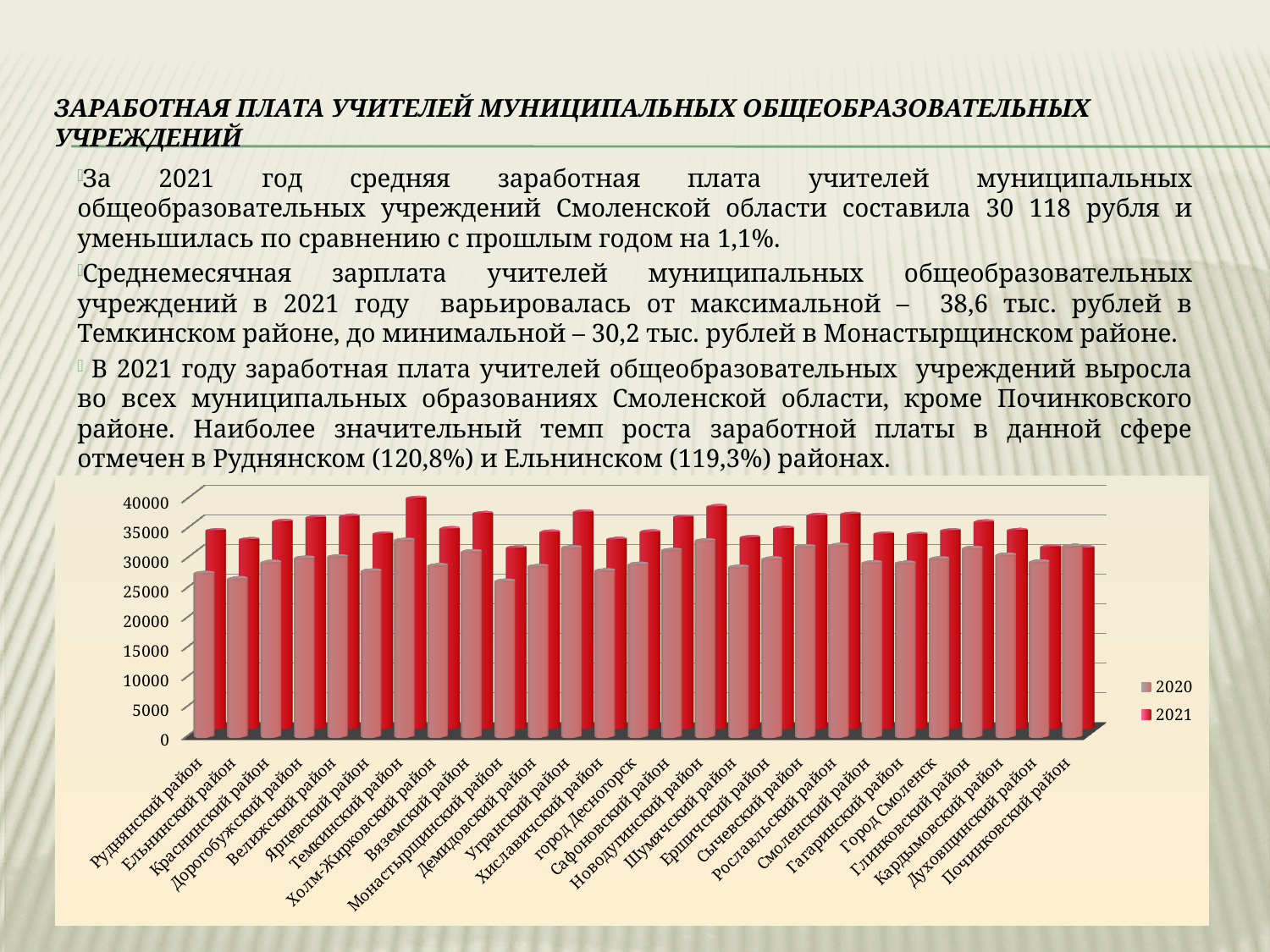
Which colour represents the 2021 series in the chart? Red How many districts (categories) are shown on the x axis of the chart? 27 Which years are listed in the chart legend? 2020 and 2021 Is the 2020 value for Монастырщинский район greater or less than 30000? less Which district has the highest 2021 value in the chart? Темкинский район Is the 2020 value for Руднянский район greater or less than 30000? less How many series does the legend list? 2 Which district has the larger 2021 value: Темкинский район or Руднянский район? Темкинский район Which is larger for Руднянский район: the 2020 value or the 2021 value? 2021 Is the 2021 value for Темкинский район greater or less than 35000? greater What kind of chart is shown on the slide? Bar chart